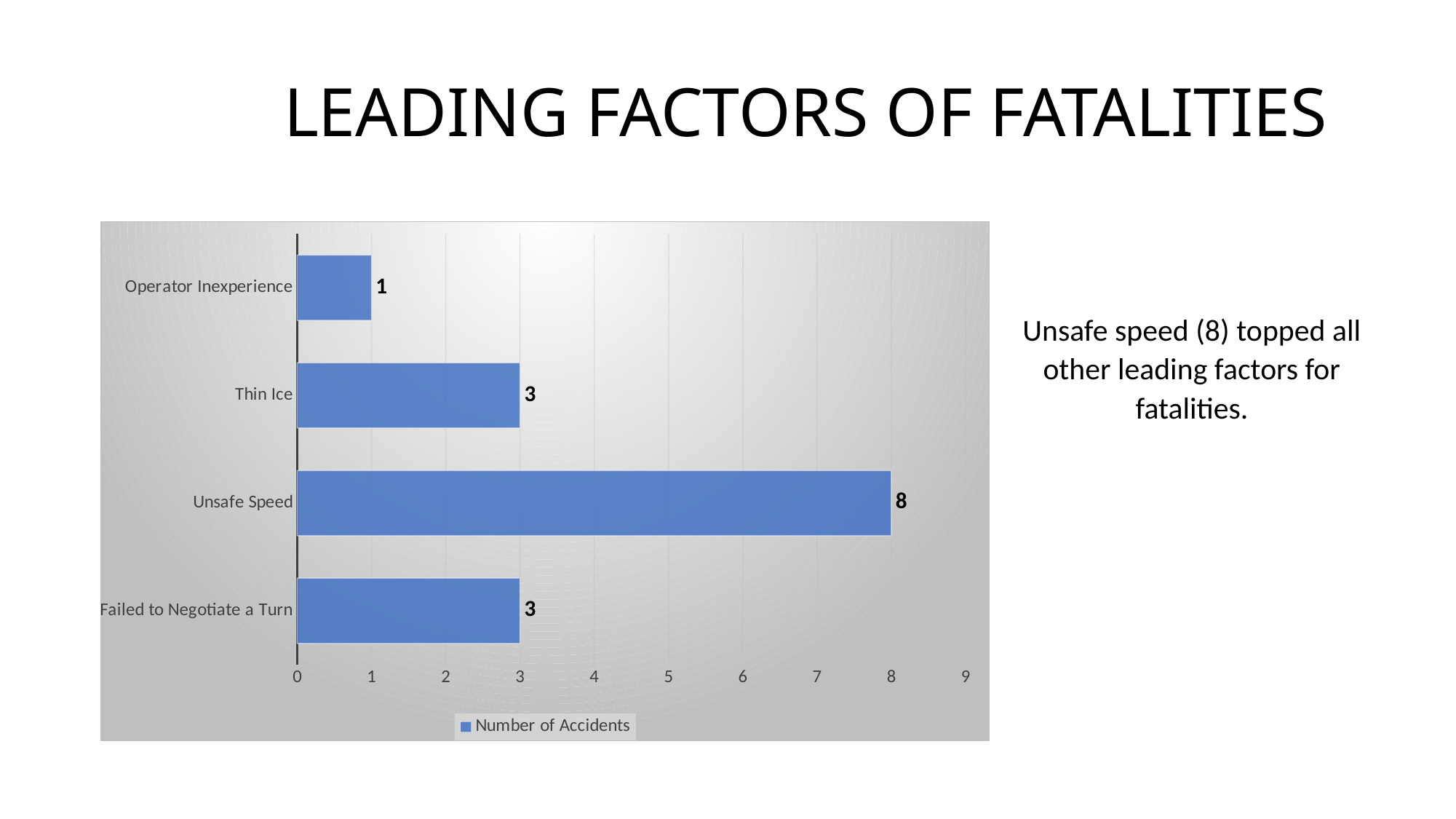
What is the number of accidents for Thin Ice? 3 How many categories are shown in the chart? 4 What series name is shown in the chart legend? Number of Accidents Which category has the lowest number of accidents? Operator Inexperience Is the value for Unsafe Speed greater or less than 5? greater Which category has the highest number of accidents? Unsafe Speed What is the number of accidents for Unsafe Speed? 8 Which has more accidents, Failed to Negotiate a Turn or Operator Inexperience? Failed to Negotiate a Turn What is the number of accidents for Operator Inexperience? 1 How many series does the legend list? 1 What kind of chart is shown on the slide? Bar chart What is the difference in number of accidents between Unsafe Speed and Thin Ice? 5